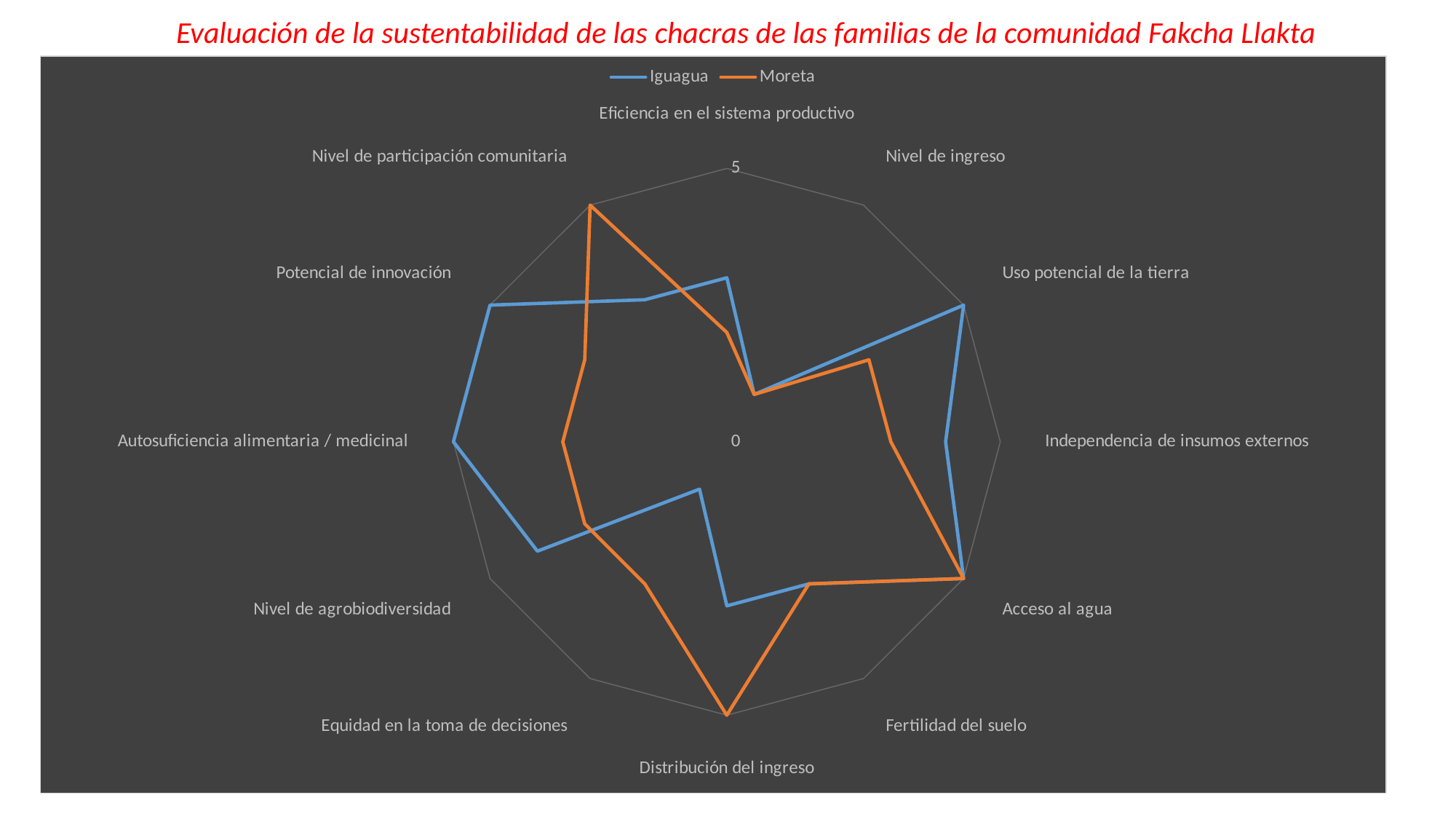
What is the maximum value shown on the radar chart's axis scale? 5 How many categories (axes) does the radar chart have? 12 How many series does the legend list? 2 On which category does Moreta have its lowest value? Nivel de ingreso Which series is drawn in orange? Moreta What is the value for Iguagua on Autosuficiencia alimentaria / medicinal? 5 What is the value for Moreta on Distribución del ingreso? 5 Which series has the higher value on Equidad en la toma de decisiones, Iguagua or Moreta? Moreta What kind of chart is shown on the slide? Radar chart What is the value for Iguagua on Uso potencial de la tierra? 5 Which series has the higher value on Nivel de participación comunitaria, Iguagua or Moreta? Moreta Which series has the higher value on Potencial de innovación, Iguagua or Moreta? Iguagua